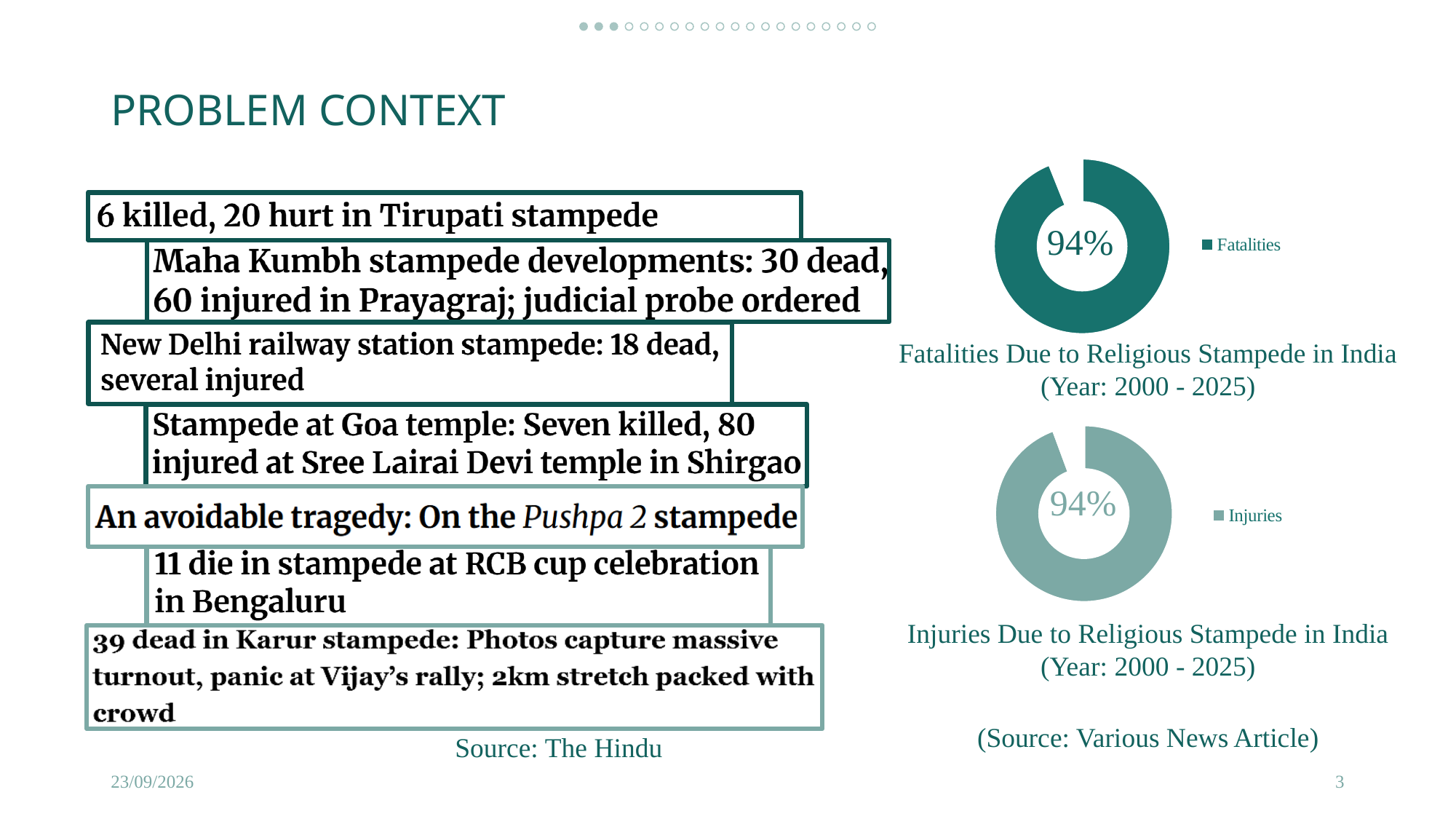
How many entries does the legend of the 'Injuries Due to Religious Stampede in India' chart list? 1 What is the legend entry shown next to the top doughnut chart on the right? Fatalities What kind of chart is the bottom chart on the right, titled 'Injuries Due to Religious Stampede in India'? Doughnut chart In the 'Fatalities Due to Religious Stampede in India' chart, what percentage is shown in the centre of the doughnut? 94% In the 'Injuries Due to Religious Stampede in India' chart, what percentage is shown in the centre of the doughnut? 94% Is the Fatalities share in the 'Fatalities Due to Religious Stampede in India' chart larger or smaller than the Injuries share in the 'Injuries Due to Religious Stampede in India' chart? They are equal (both 94%) How many entries does the legend of the 'Fatalities Due to Religious Stampede in India' chart list? 1 What kind of chart is the top chart on the right, titled 'Fatalities Due to Religious Stampede in India'? Doughnut chart In the 'Injuries Due to Religious Stampede in India' chart, what share of the doughnut does the Injuries slice represent? 94% What year range is given in the title of the 'Injuries Due to Religious Stampede in India' chart? 2000 - 2025 In the 'Fatalities Due to Religious Stampede in India' chart, what share of the doughnut does the Fatalities slice represent? 94%